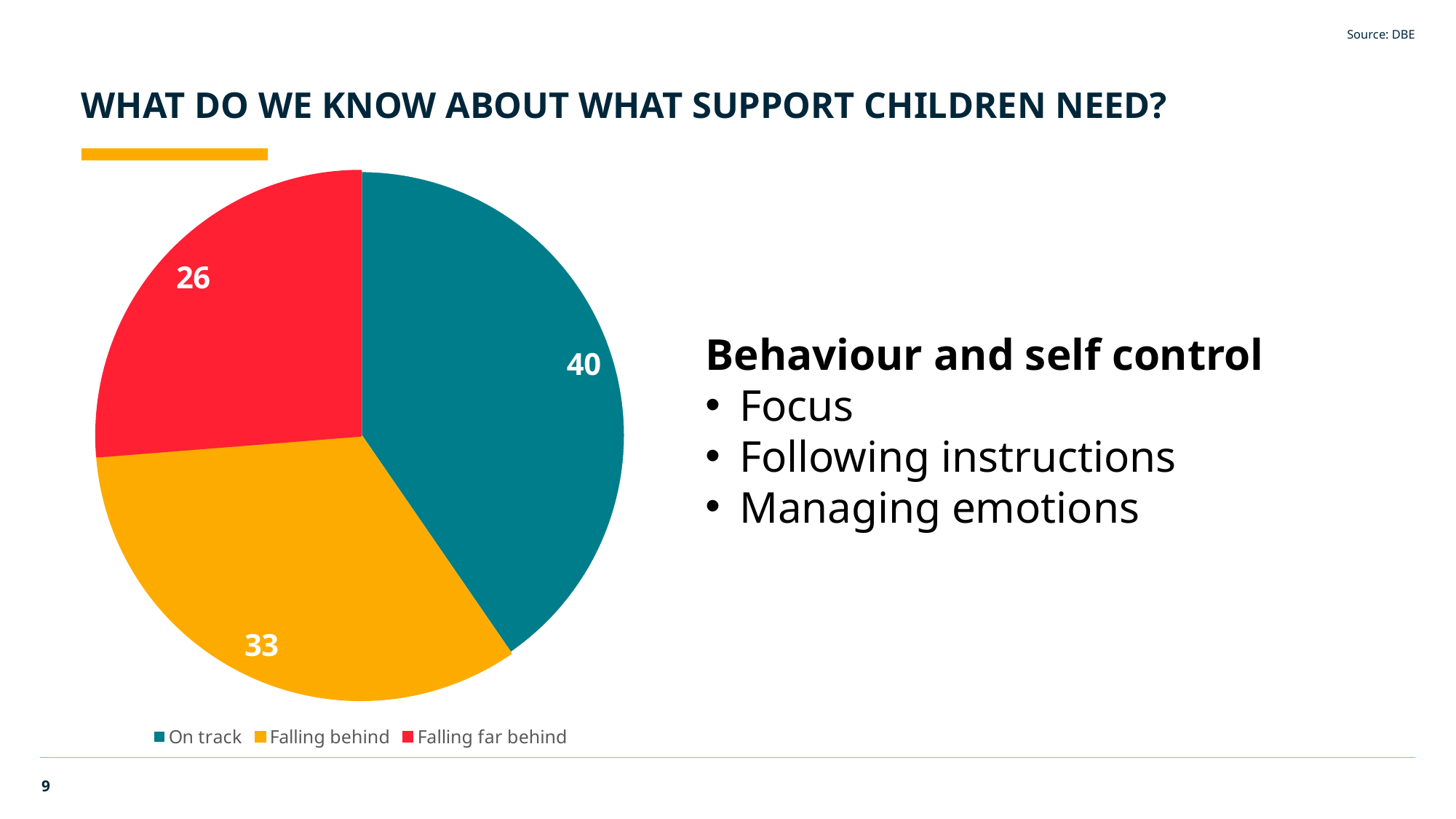
How many entries does the legend list? 3 What is the value for the Falling far behind slice of the pie chart? 26 What is the value for the On track slice of the pie chart? 40 What is the difference between the Falling behind and Falling far behind values? 7 What colour is the Falling behind slice in the pie chart? Orange What is the difference between the On track and Falling far behind values? 14 Which category has the largest slice in the pie chart? On track Which is larger, the On track slice or the Falling behind slice? On track How many slices does the pie chart have? 3 Which category has the smallest slice in the pie chart? Falling far behind What kind of chart is shown on the slide? Pie chart What is the value for the Falling behind slice of the pie chart? 33